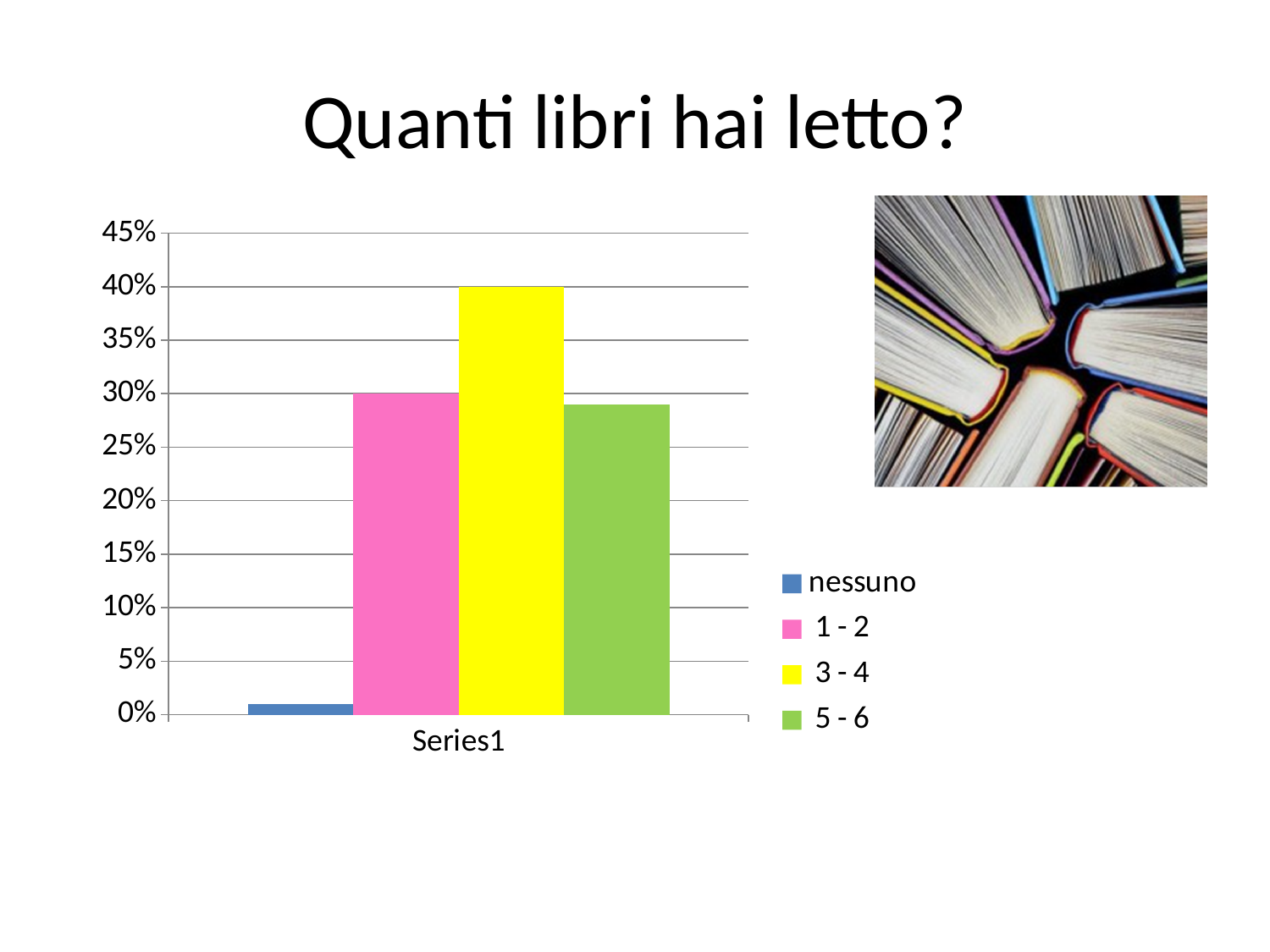
Which series has the highest value? 3 - 4 What is the title of the chart on the slide? Quanti libri hai letto? What is the value for the '1 - 2' series? 30% Is the value for 'nessuno' greater or less than 5%? less Which is larger, the value for '3 - 4' or the value for '5 - 6'? 3 - 4 What is the value for the '3 - 4' series? 40% How many series does the legend list? 4 Which series has the lowest value? nessuno Is the value for '5 - 6' greater or less than 25%? greater Which colour represents the '3 - 4' series in the legend? yellow What is the difference between the values for '3 - 4' and '1 - 2'? 10% What kind of chart is shown on the slide? bar chart